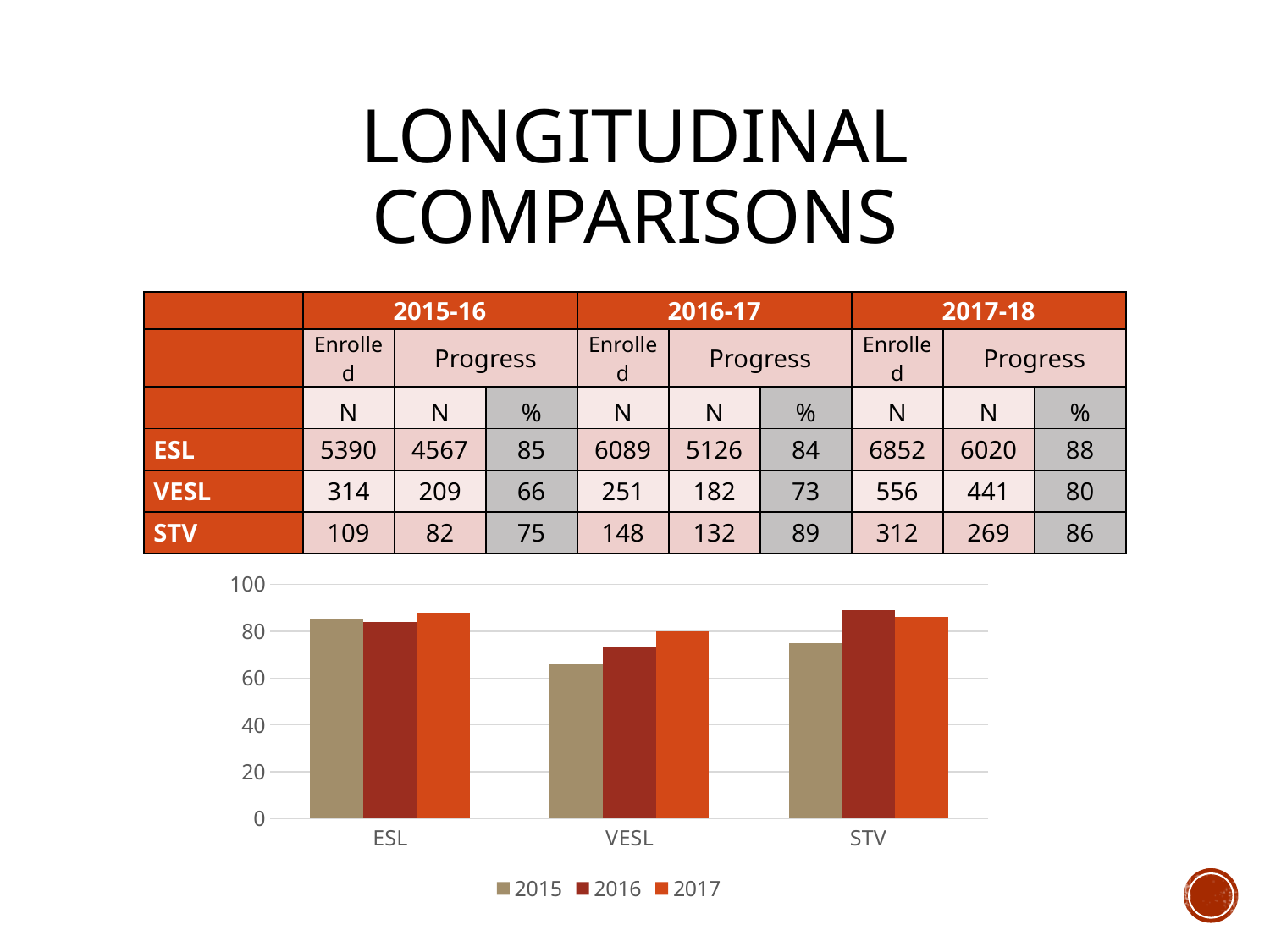
What kind of chart is shown below the table? bar chart Which is larger in the chart: VESL in 2015 or VESL in 2017? VESL in 2017 How many categories are shown on the x axis of the chart? 3 Is the value for STV in 2016 greater or less than 80? greater Which bar in the chart is the lowest overall? VESL in 2015 Do the VESL bars rise or fall from 2015 to 2017? rise How many series does the chart's legend list? 3 Using the percentages in the table, what is the difference between VESL's progress % in 2017-18 and 2015-16? 14 For STV, which year has the highest bar? 2016 What entries does the chart's legend list? 2015, 2016, 2017 According to the table, what is the progress percentage for ESL in 2017-18? 88 Is the value for VESL in 2015 greater or less than 80? less